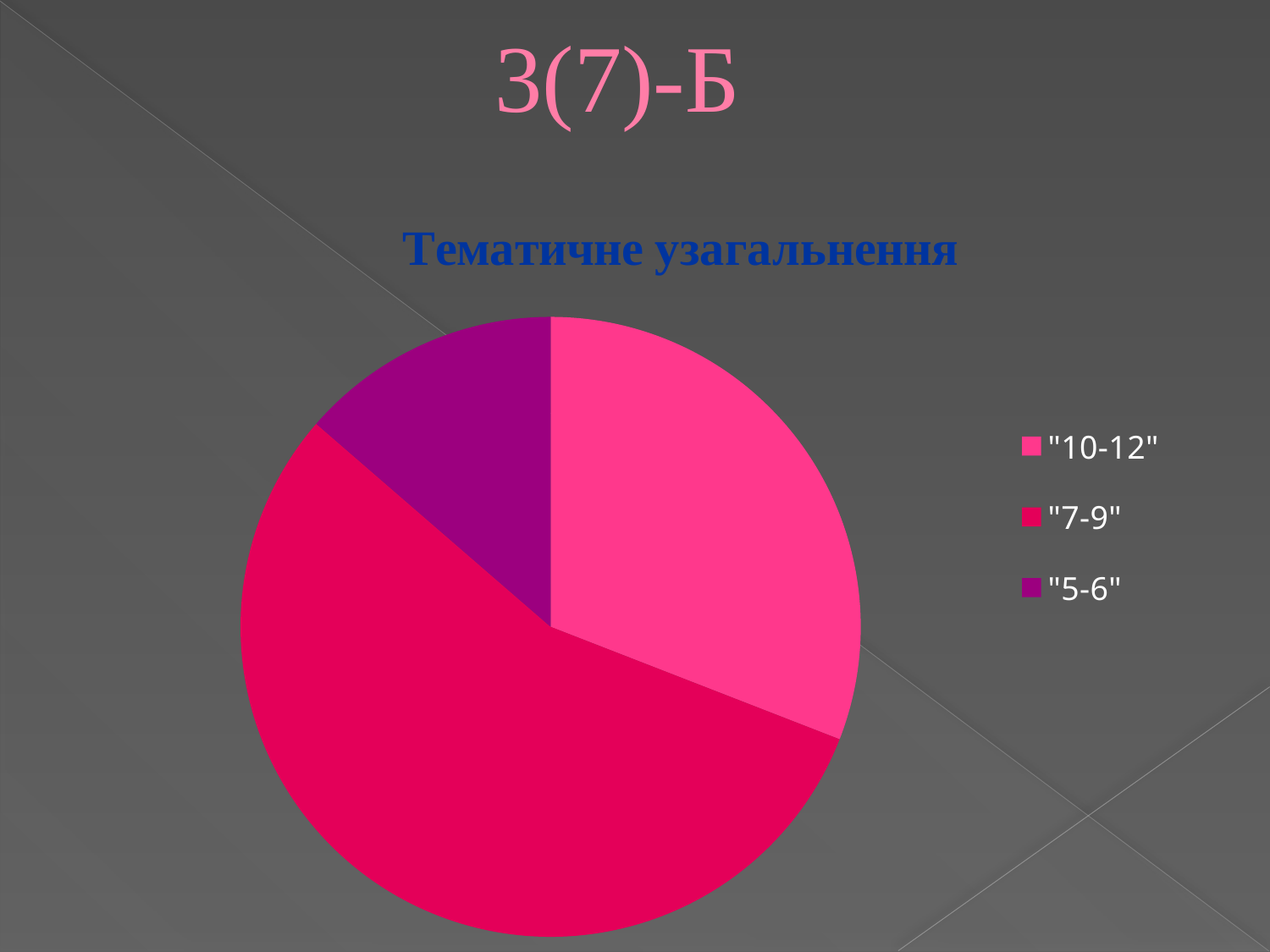
Which slice is larger, "10-12" or "5-6"? "10-12" How many entries does the legend list? 3 Which category has the largest slice of the pie? "7-9" How many slices does the pie chart have? 3 What kind of chart is shown on the slide? pie chart Which category is shown in purple in the pie chart? "5-6" Which slice is larger, "7-9" or "10-12"? "7-9" Which category has the smallest slice of the pie? "5-6" What is the title of the chart? Тематичне узагальнення